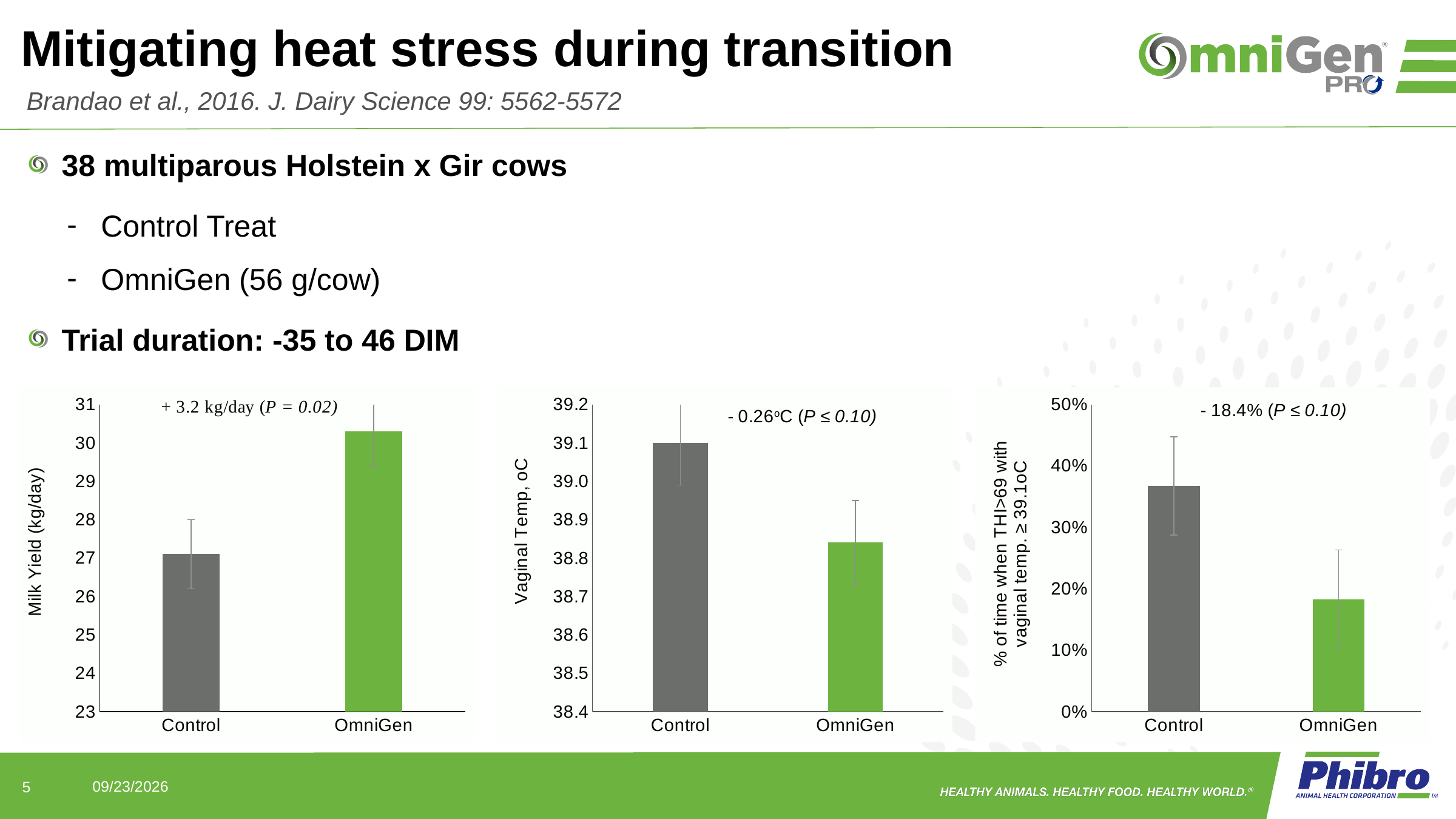
In the chart on the right showing % of time when THI>69 with vaginal temp. ≥ 39.1oC, is the value for OmniGen greater or less than 20%? less In the Milk Yield (kg/day) chart on the left, is the value for OmniGen greater or less than 30? greater In the chart on the right showing % of time when THI>69 with vaginal temp. ≥ 39.1oC, which group has the larger value, Control or OmniGen? Control In the Vaginal Temp, oC chart in the middle, is the value for OmniGen greater or less than 38.9? less What difference between groups is annotated at the top of the Milk Yield (kg/day) chart on the left? + 3.2 kg/day (P = 0.02) In the Vaginal Temp, oC chart in the middle, which group has the lower vaginal temperature? OmniGen In the Milk Yield (kg/day) chart on the left, which group has the higher milk yield? OmniGen What kind of chart is the Milk Yield (kg/day) chart on the left? bar chart What difference between groups is annotated at the top of the Vaginal Temp, oC chart in the middle? - 0.26oC (P ≤ 0.10) How many bars are plotted in the Milk Yield (kg/day) chart on the left? 2